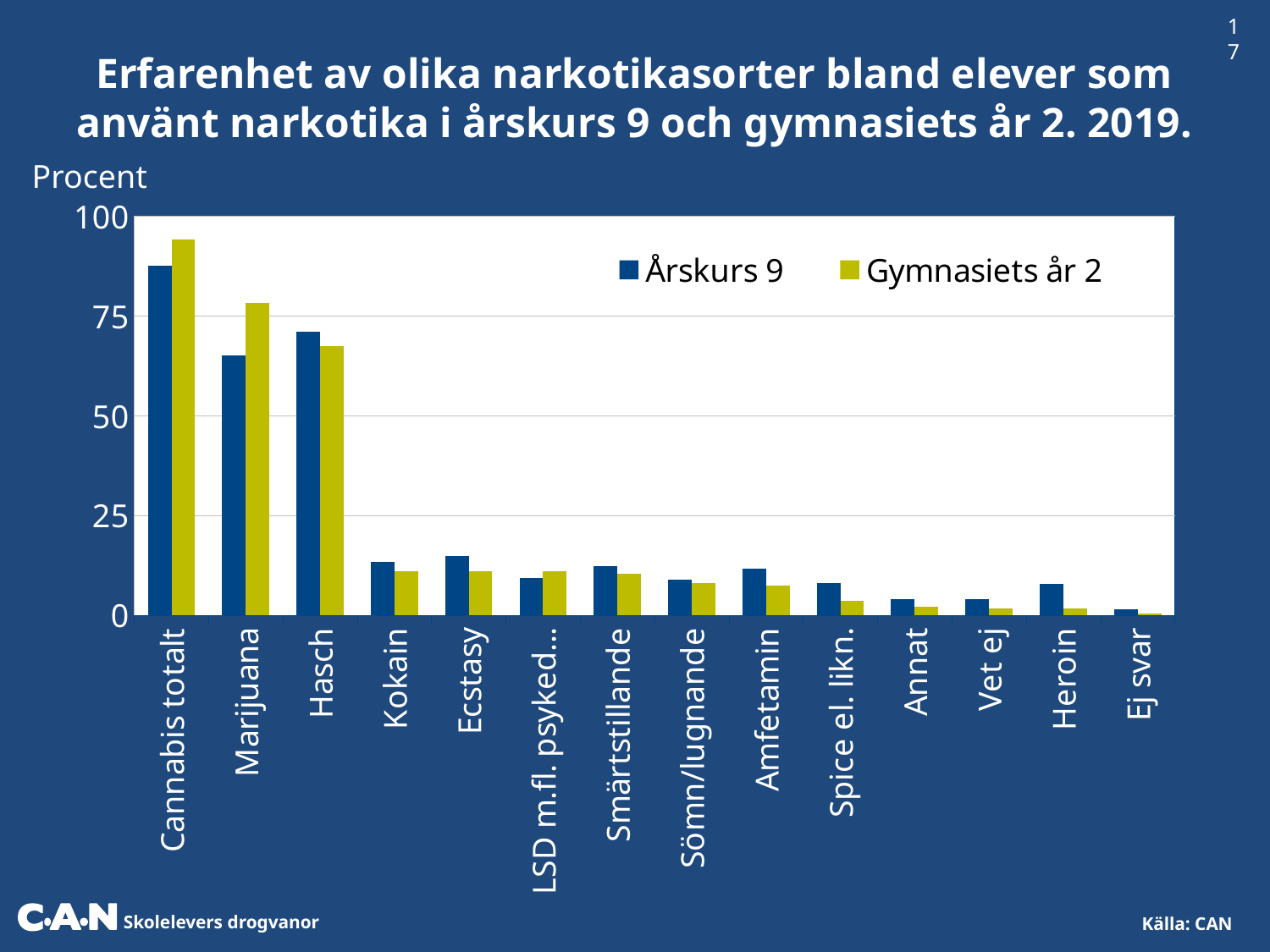
Which category has the lowest value for Gymnasiets år 2? Ej svar What unit is shown on the y axis label? Procent What kind of chart is shown on the slide? bar chart How many categories are shown on the x axis? 14 Which category has the highest value for Årskurs 9? Cannabis totalt How many series does the legend list? 2 For Cannabis totalt, which series has the larger value, Årskurs 9 or Gymnasiets år 2? Gymnasiets år 2 Is the value for Kokain in Årskurs 9 greater or less than 25? less Is the value for Cannabis totalt in Gymnasiets år 2 greater or less than 75? greater For Heroin, which series has the larger value, Årskurs 9 or Gymnasiets år 2? Årskurs 9 Is the value for Marijuana in Årskurs 9 greater or less than 50? greater For Hasch, which series has the larger value, Årskurs 9 or Gymnasiets år 2? Årskurs 9